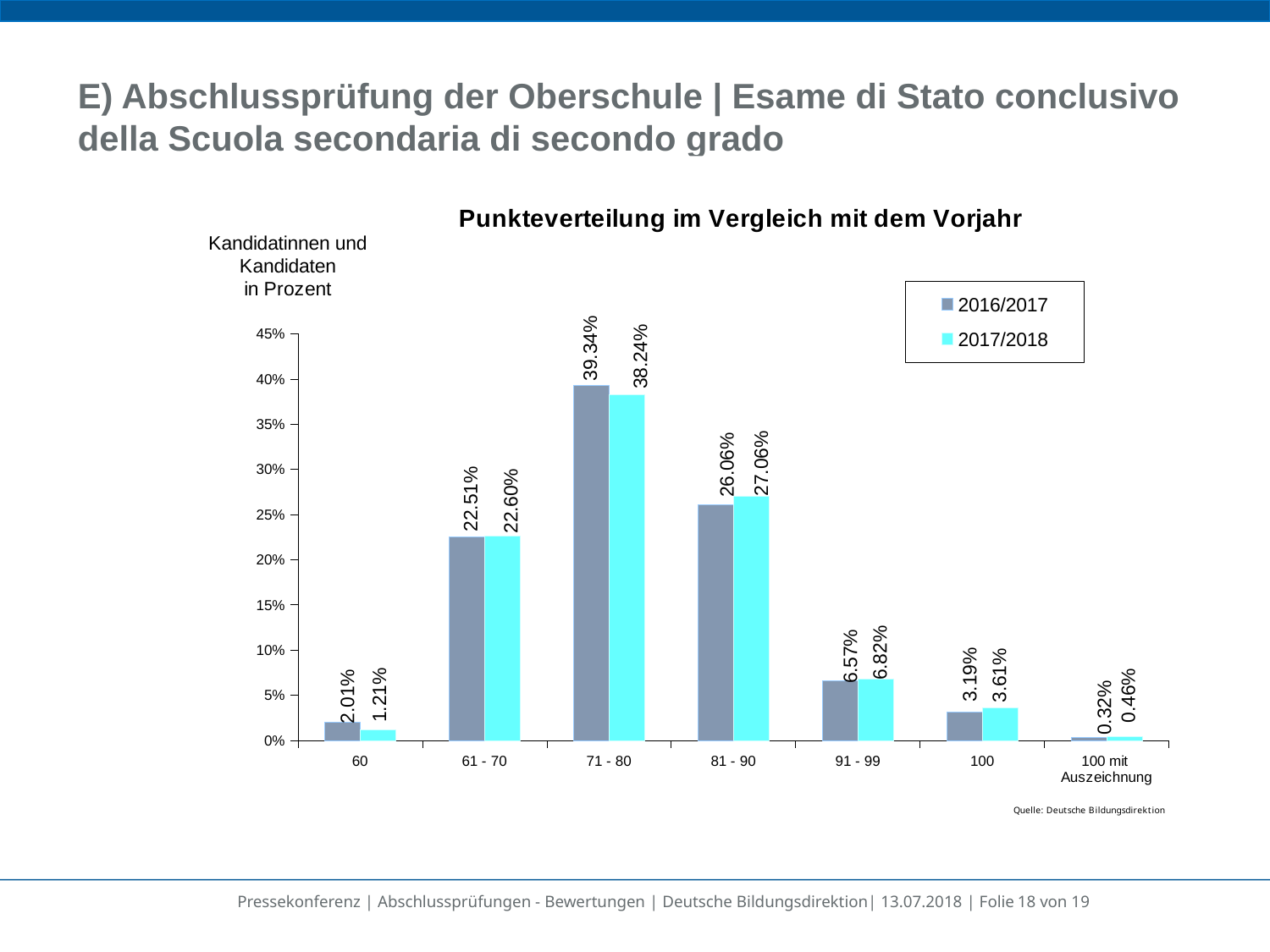
Which category has the lowest value in the 2017/2018 series? 100 mit Auszeichnung What is the value for the 100 mit Auszeichnung category in the 2017/2018 series? 0.46% What is the value for the 60 category in the 2016/2017 series? 2.01% What is the value for the 71 - 80 category in the 2017/2018 series? 38.24% For the 91 - 99 category, which series has the larger value, 2016/2017 or 2017/2018? 2017/2018 What kind of chart is shown on the slide? bar chart Which category has the highest value in the 2016/2017 series? 71 - 80 What is the difference between the 2016/2017 and 2017/2018 values for the 81 - 90 category? 1.00% Is the 2017/2018 value for the 61 - 70 category greater or less than 20%? greater How many categories are shown on the x axis? 7 How many series does the legend list? 2 What is the title of the chart? Punkteverteilung im Vergleich mit dem Vorjahr